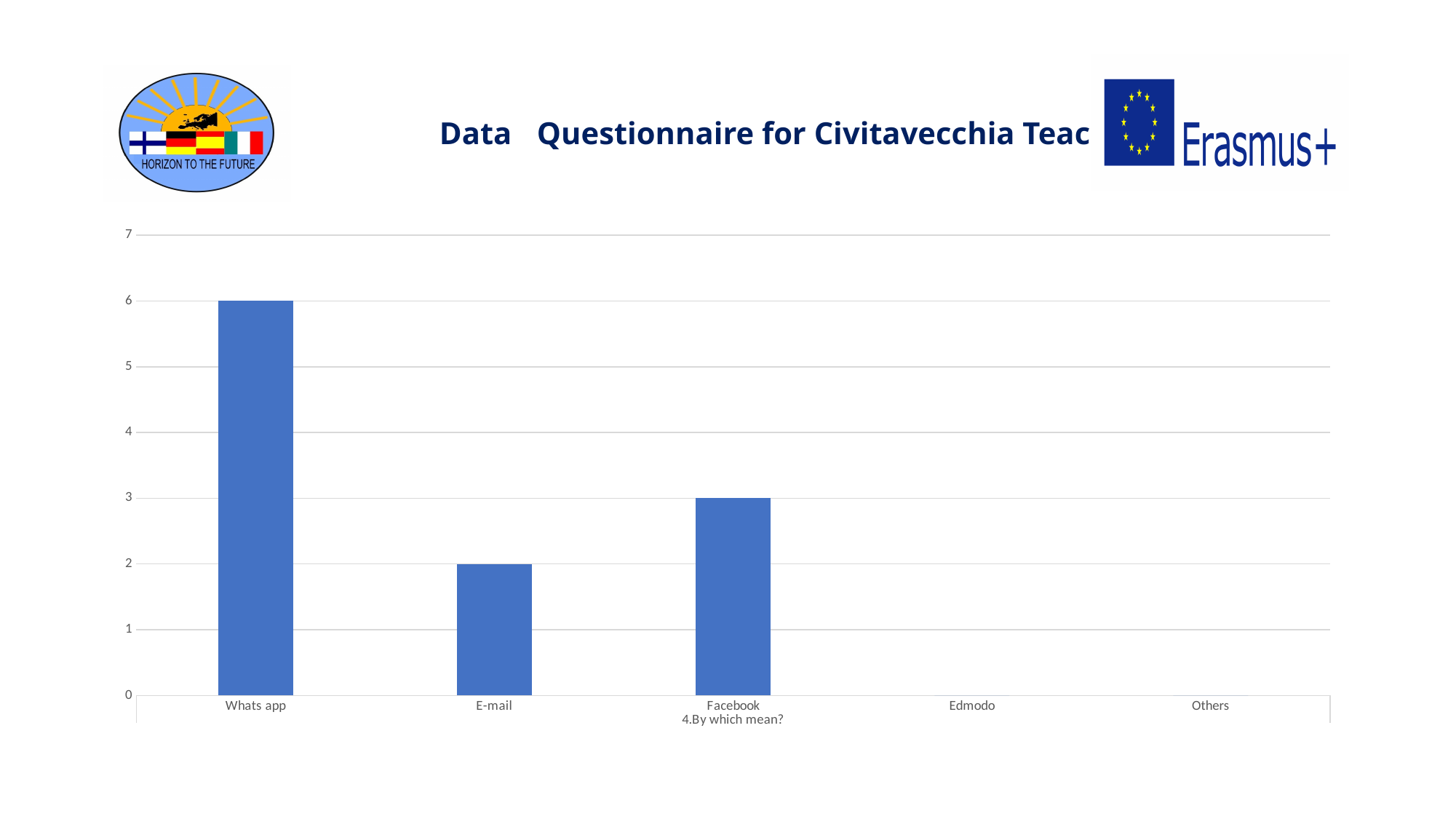
How many categories are shown on the x axis of the chart? 5 What is the label shown under the x axis of the chart? 4.By which mean? What is the value for Facebook? 3 Which is larger, the value for E-mail or the value for Facebook? Facebook What is the difference between the values for Facebook and E-mail? 1 What is the difference between the values for Whats app and Facebook? 3 What is the value for E-mail? 2 Is the value for Whats app greater or less than 5? greater What is the value for Whats app? 6 Which category has the highest value? Whats app What kind of chart is shown on the slide? bar chart Is the value for E-mail greater or less than 3? less